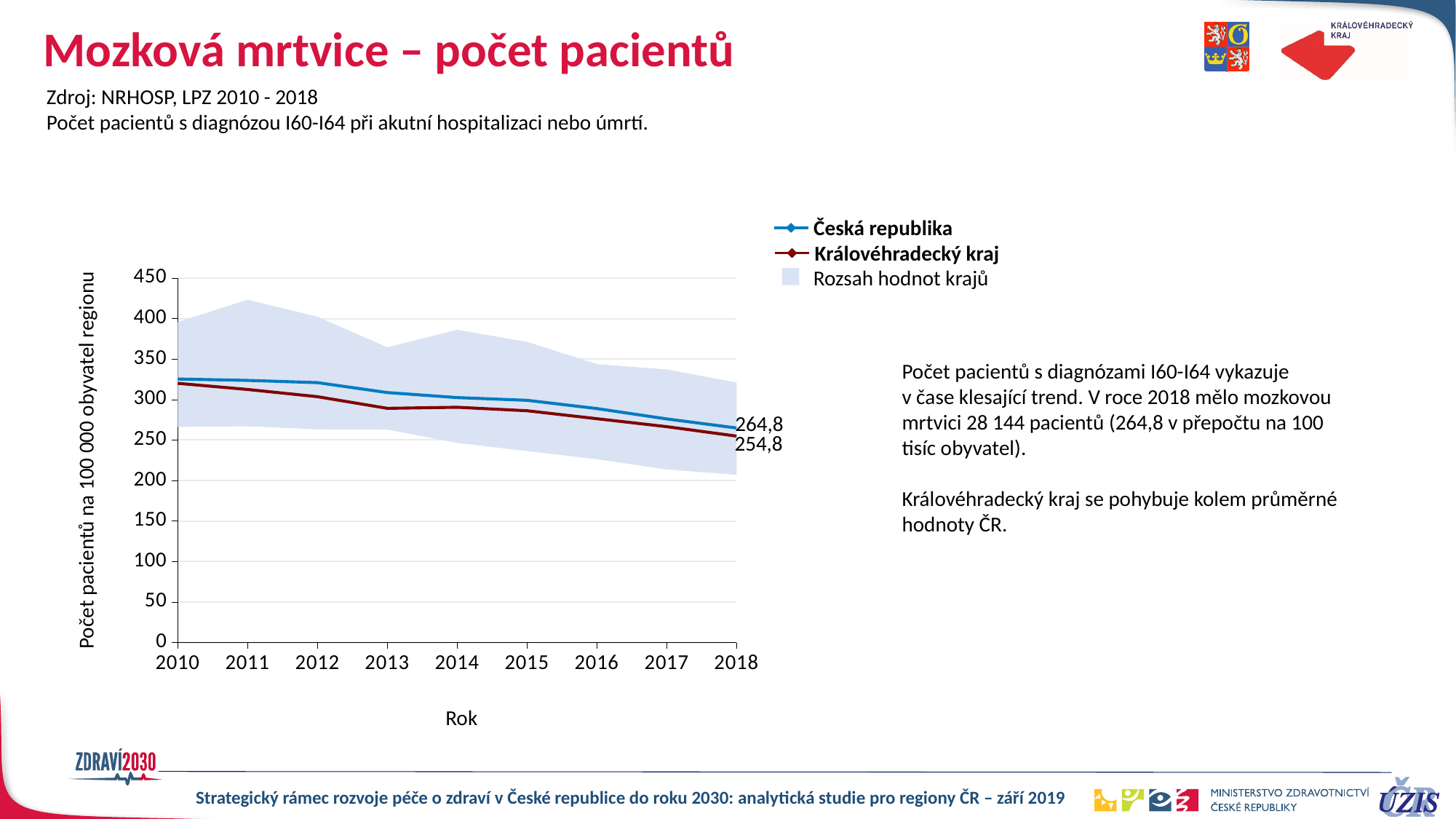
Is the value for Královéhradecký kraj in 2016 greater or less than 300? less Is the value for Česká republika in 2010 greater or less than 300? greater What is the value for Královéhradecký kraj in 2018? 254,8 What is the title of the y axis? Počet pacientů na 100 000 obyvatel regionu What kind of chart is shown on the slide? line chart What is the title of the x axis? Rok How many years are shown on the x axis? 9 In 2018, which series has the higher value: Česká republika or Královéhradecký kraj? Česká republika What is the difference between the 2018 values for Česká republika and Královéhradecký kraj? 10,0 What is the value for Česká republika in 2018? 264,8 How many entries does the legend list? 3 Do the values for Česká republika rise or fall from 2010 to 2018? fall